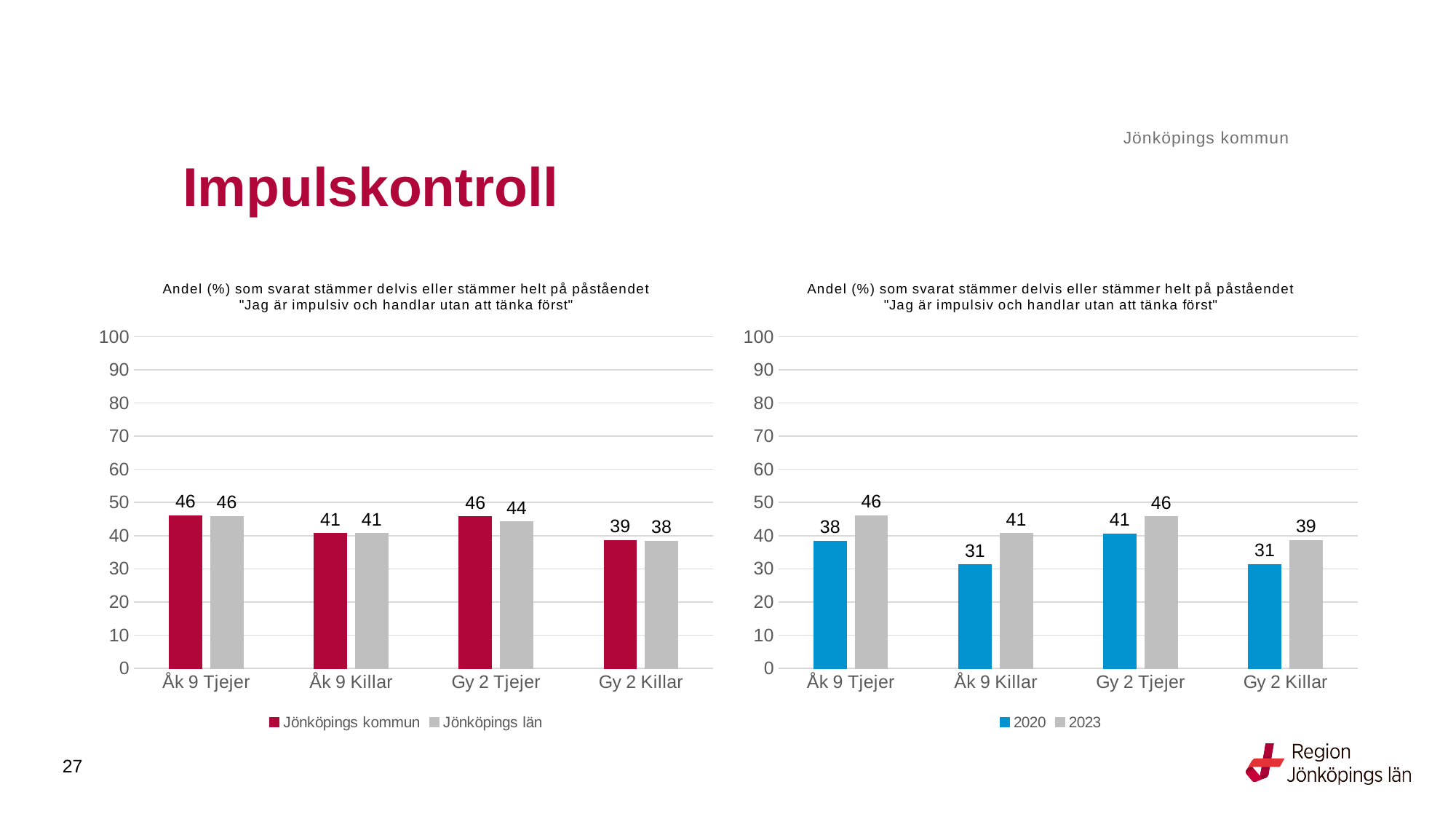
In the left chart, what is the value for Jönköpings län for Gy 2 Killar? 38 In the left chart, what is the value for Jönköpings kommun for Gy 2 Tjejer? 46 In the right chart, is the 2020 value for Åk 9 Tjejer larger or smaller than the 2023 value? smaller In the left chart, which category has the lowest Jönköpings kommun value? Gy 2 Killar In the right chart, what is the 2023 value for Gy 2 Killar? 39 What type of chart is the right chart? bar chart In the right chart, which category has the lowest 2023 value? Gy 2 Killar In the right chart, what is the 2020 value for Åk 9 Killar? 31 How many categories are shown on the x axis of the right chart? 4 In the left chart, what is the difference between Jönköpings kommun and Jönköpings län for Gy 2 Tjejer? 2 How many series does the legend of the left chart list? 2 In the right chart, what is the difference between the 2023 and 2020 values for Åk 9 Killar? 10